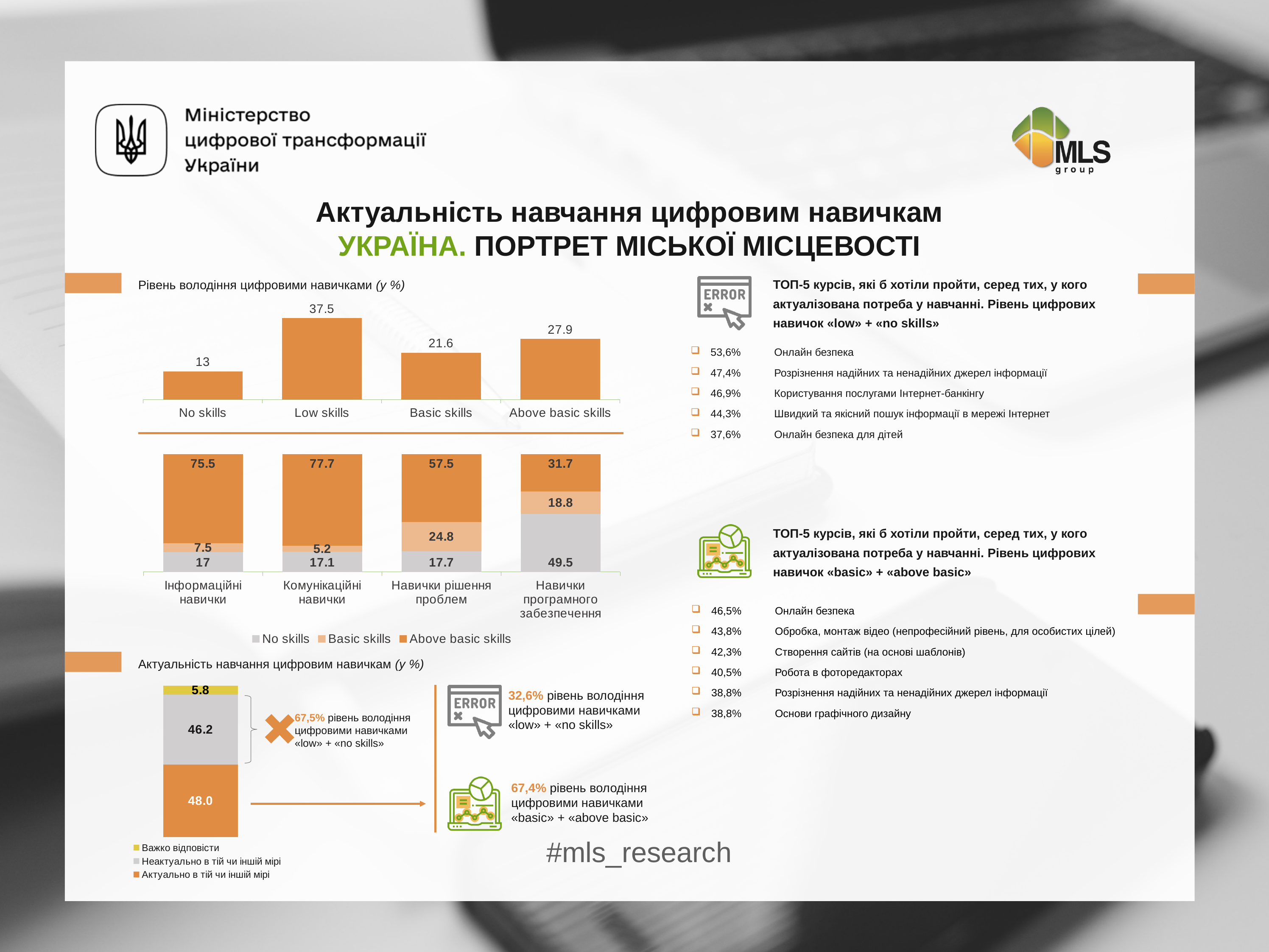
In the stacked bar chart in the middle left, how many series does the legend list? 3 In the top chart 'Рівень володіння цифровими навичками (у %)', which category has the highest value? Low skills In the stacked bar chart in the middle left, what is the 'No skills' value for Навички програмного забезпечення? 49.5 In the stacked bar chart in the middle left, what is the 'Above basic skills' value for Комунікаційні навички? 77.7 In the chart 'Актуальність навчання цифровим навичкам (у %)', what is the value for 'Актуально в тій чи іншій мірі'? 48.0 In the stacked bar chart in the middle left, what is the total of the stacked bar for Навички рішення проблем? 100 In the top chart 'Рівень володіння цифровими навичками (у %)', what is the value for Low skills? 37.5 In the top chart 'Рівень володіння цифровими навичками (у %)', which category has the lowest value? No skills In the stacked bar chart in the middle left, which is larger: the 'Basic skills' value for Навички рішення проблем or for Інформаційні навички? Навички рішення проблем In the top chart 'Рівень володіння цифровими навичками (у %)', how many categories are shown? 4 What kind of chart is 'Рівень володіння цифровими навичками (у %)' at the top left? bar chart In the top chart 'Рівень володіння цифровими навичками (у %)', what is the difference between Above basic skills and Basic skills? 6.3